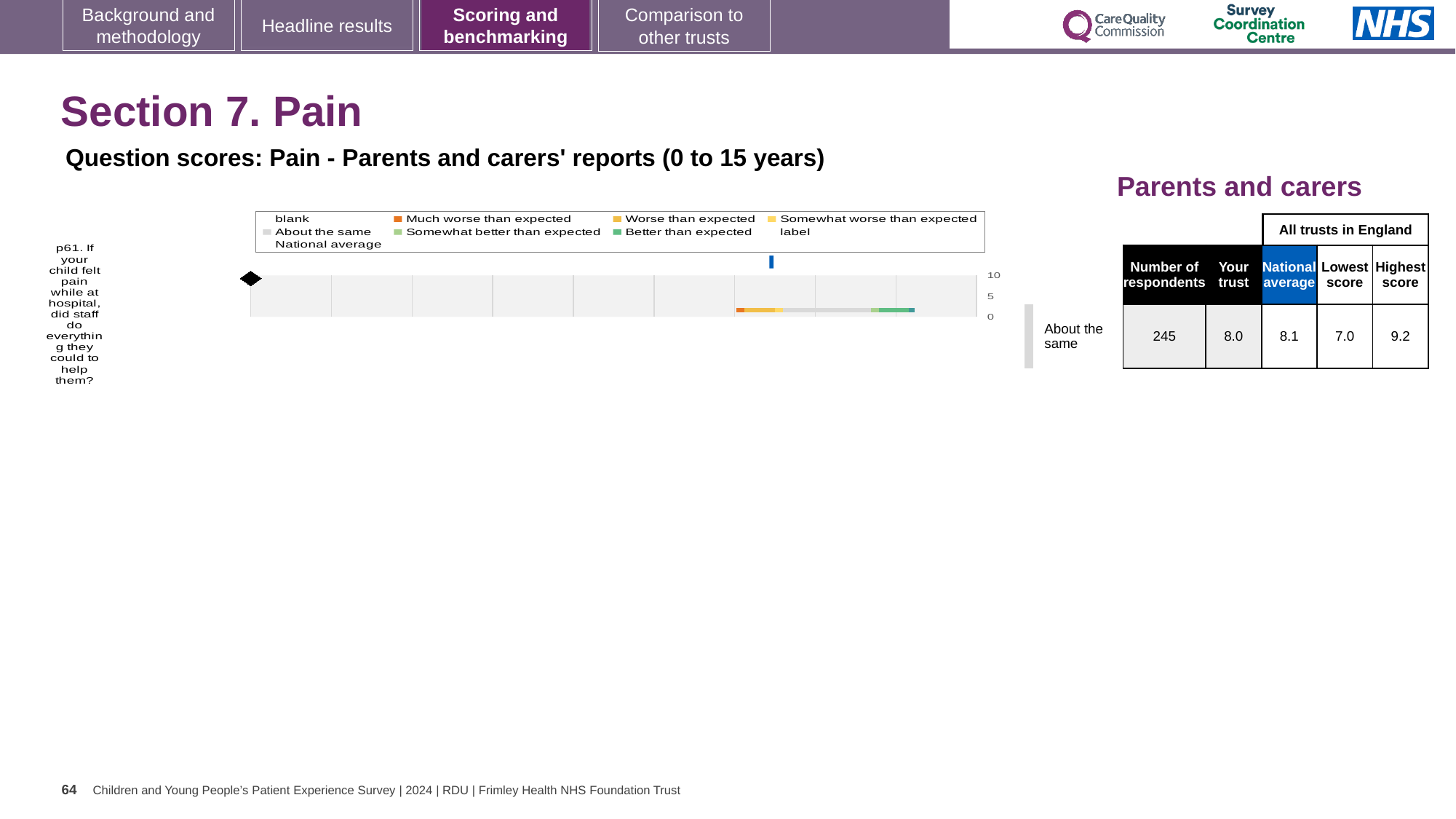
What is the lowest score among all trusts in England for question p61? 7.0 What colour represents 'Much worse than expected' in the chart legend? Orange Which is larger for question p61, the 'Your trust' score or the national average? National average What is the 'Your trust' score for question p61? 8.0 What is the highest score among all trusts in England for question p61? 9.2 Which benchmark category is the trust's result for question p61 placed in? About the same How many survey questions are plotted in the chart? 1 Is the 'Your trust' score for question p61 greater or less than 5? greater How many respondents answered question p61? 245 What is the national average score for question p61? 8.1 What is the difference between the highest score and the lowest score for question p61? 2.2 What kind of chart is shown on the slide? bar chart